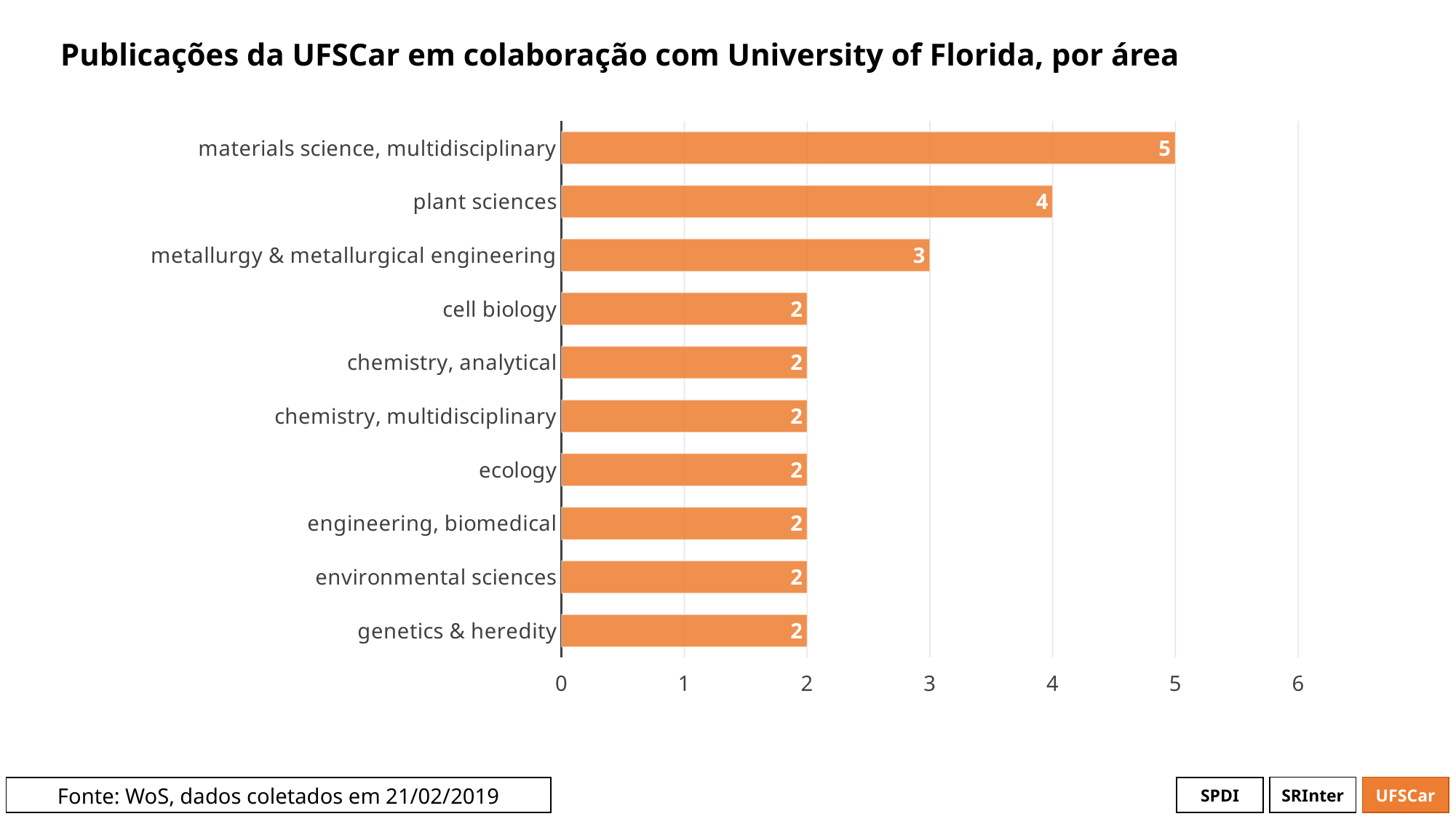
What is the value for plant sciences? 4 What is the title of the chart? Publicações da UFSCar em colaboração com University of Florida, por área What kind of chart is shown on the slide? bar chart What is the value for materials science, multidisciplinary? 5 How many areas are shown in the chart? 10 Which is larger, the value for plant sciences or the value for metallurgy & metallurgical engineering? plant sciences What is the value for metallurgy & metallurgical engineering? 3 What is the difference between the values for plant sciences and cell biology? 2 What is the value for ecology? 2 Which area has the highest value? materials science, multidisciplinary What is the difference between the values for materials science, multidisciplinary and plant sciences? 1 Is the value for materials science, multidisciplinary greater or less than 4? greater